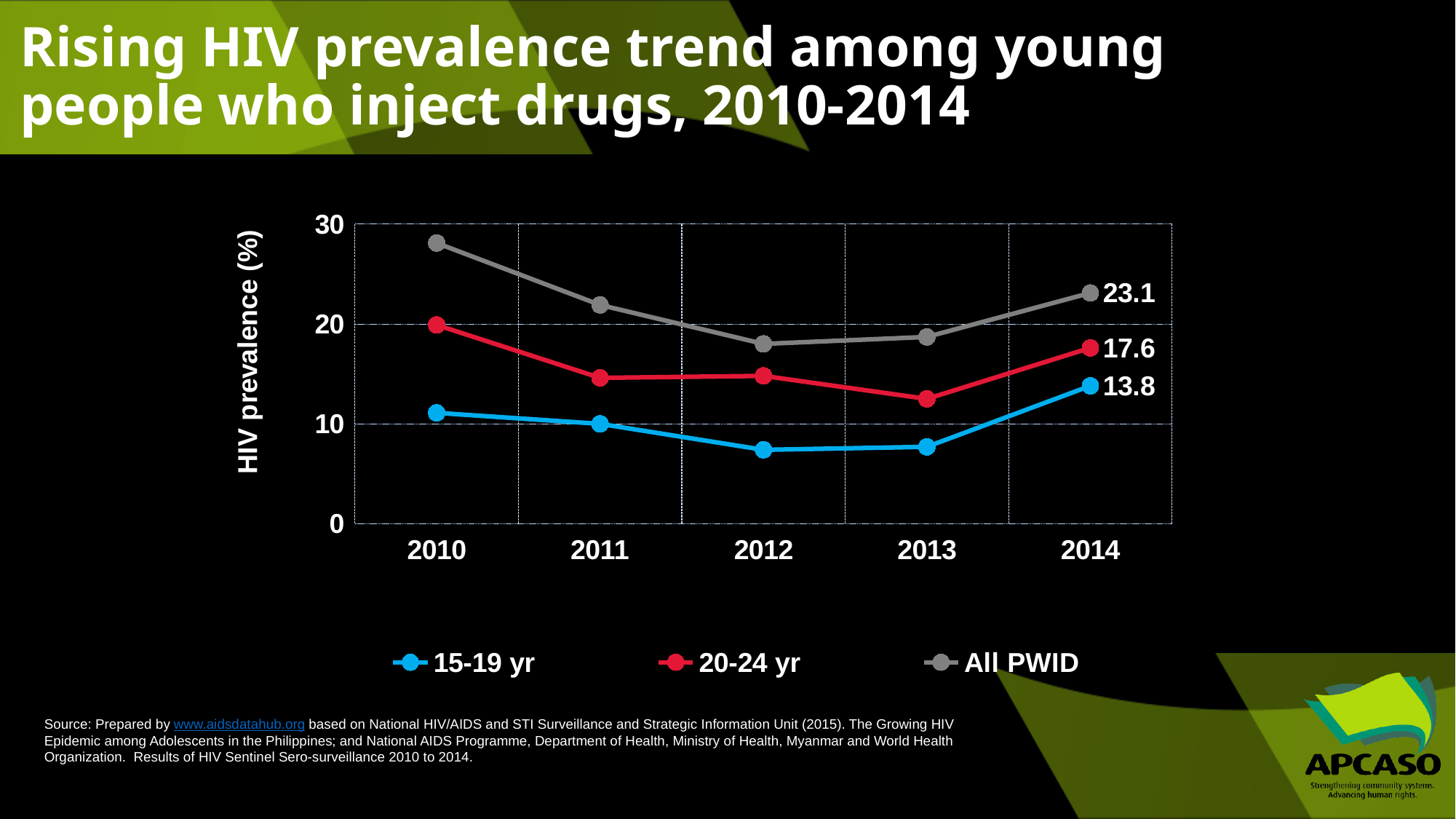
Is the value for All PWID in 2010 greater or less than 20? greater What is the HIV prevalence for the 20-24 yr group in 2014? 17.6 In 2014, which is larger: the 20-24 yr value or the 15-19 yr value? 20-24 yr What is the HIV prevalence for the 15-19 yr group in 2014? 13.8 Is the value for the 15-19 yr group in 2012 greater or less than 10? less What is the difference between the All PWID value and the 15-19 yr value in 2014? 9.3 How many series does the legend list? 3 Which series has the highest value in 2014? All PWID What is the difference between the 20-24 yr value and the 15-19 yr value in 2014? 3.8 Does the All PWID line rise or fall from 2010 to 2012? Fall What is the HIV prevalence for All PWID in 2014? 23.1 What kind of chart is shown on the slide? Line chart